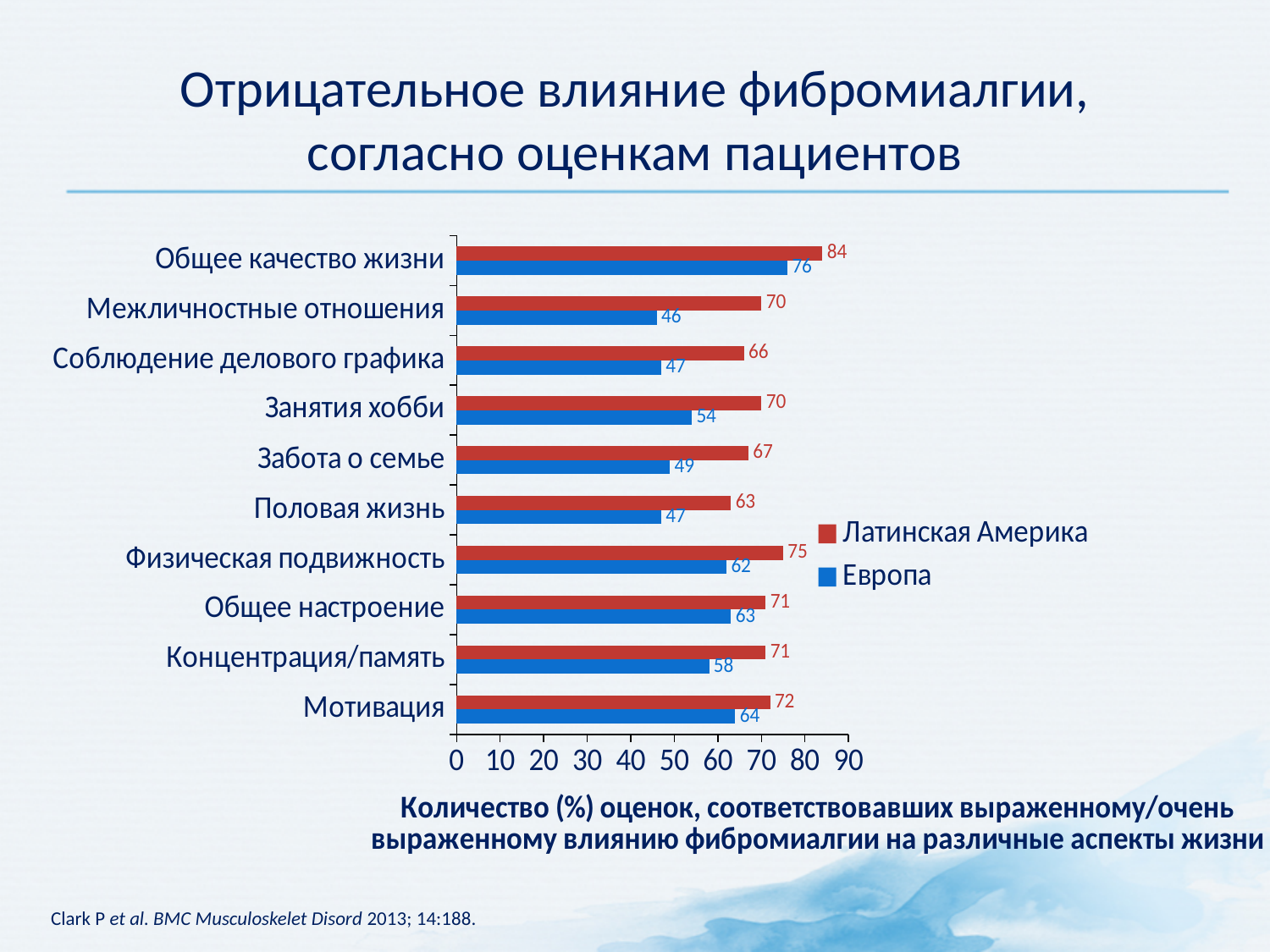
Which is larger for Физическая подвижность: the value for Латинская Америка or for Европа? Латинская Америка What is the value for Латинская Америка for Общее качество жизни? 84 How many categories are shown on the chart? 10 What is the value for Европа for Мотивация? 64 Which category has the highest value for Европа? Общее качество жизни Which category has the lowest value for Европа? Межличностные отношения What is the value for Латинская Америка for Половая жизнь? 63 What is the difference between the Латинская Америка and Европа values for Межличностные отношения? 24 What is the value for Европа for Межличностные отношения? 46 Which category has the lowest value for Латинская Америка? Половая жизнь How many series does the legend list? 2 What kind of chart is shown on the slide? Bar chart